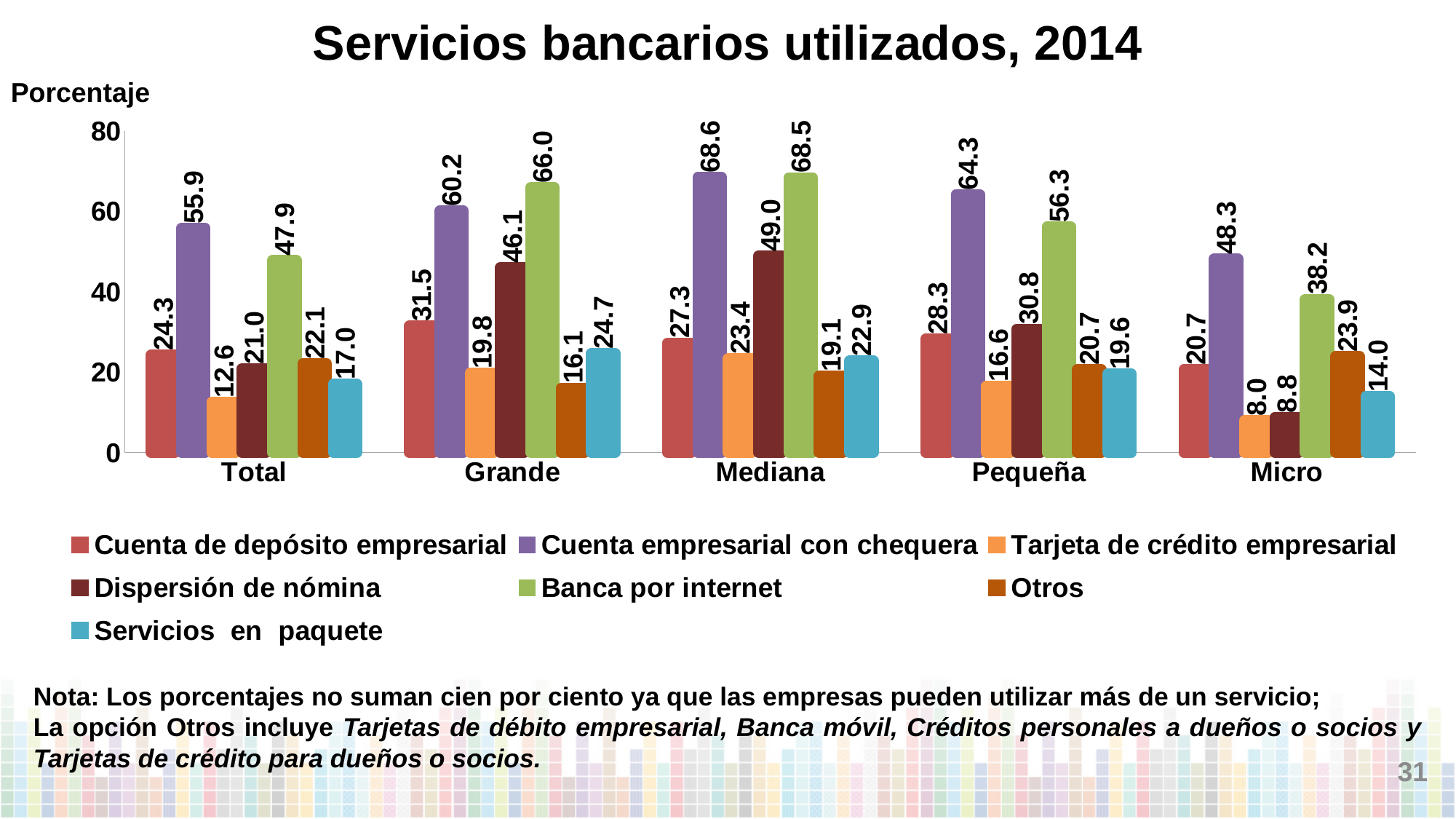
What is the value for Cuenta empresarial con chequera in the Total category? 55.9 What is the value for Dispersión de nómina in the Mediana category? 49.0 Which category has the highest value for Cuenta empresarial con chequera? Mediana What is the value for Banca por internet in the Grande category? 66.0 What kind of chart is shown on the slide? Bar chart How many series does the legend list? 7 How many categories are shown on the x axis? 5 What is the difference between Banca por internet in Grande and Banca por internet in Micro? 27.8 Which category has the lowest value for Banca por internet? Micro What is the value for Tarjeta de crédito empresarial in the Micro category? 8.0 Which is larger: Dispersión de nómina in Grande or Dispersión de nómina in Pequeña? Dispersión de nómina in Grande What is the title of the chart? Servicios bancarios utilizados, 2014